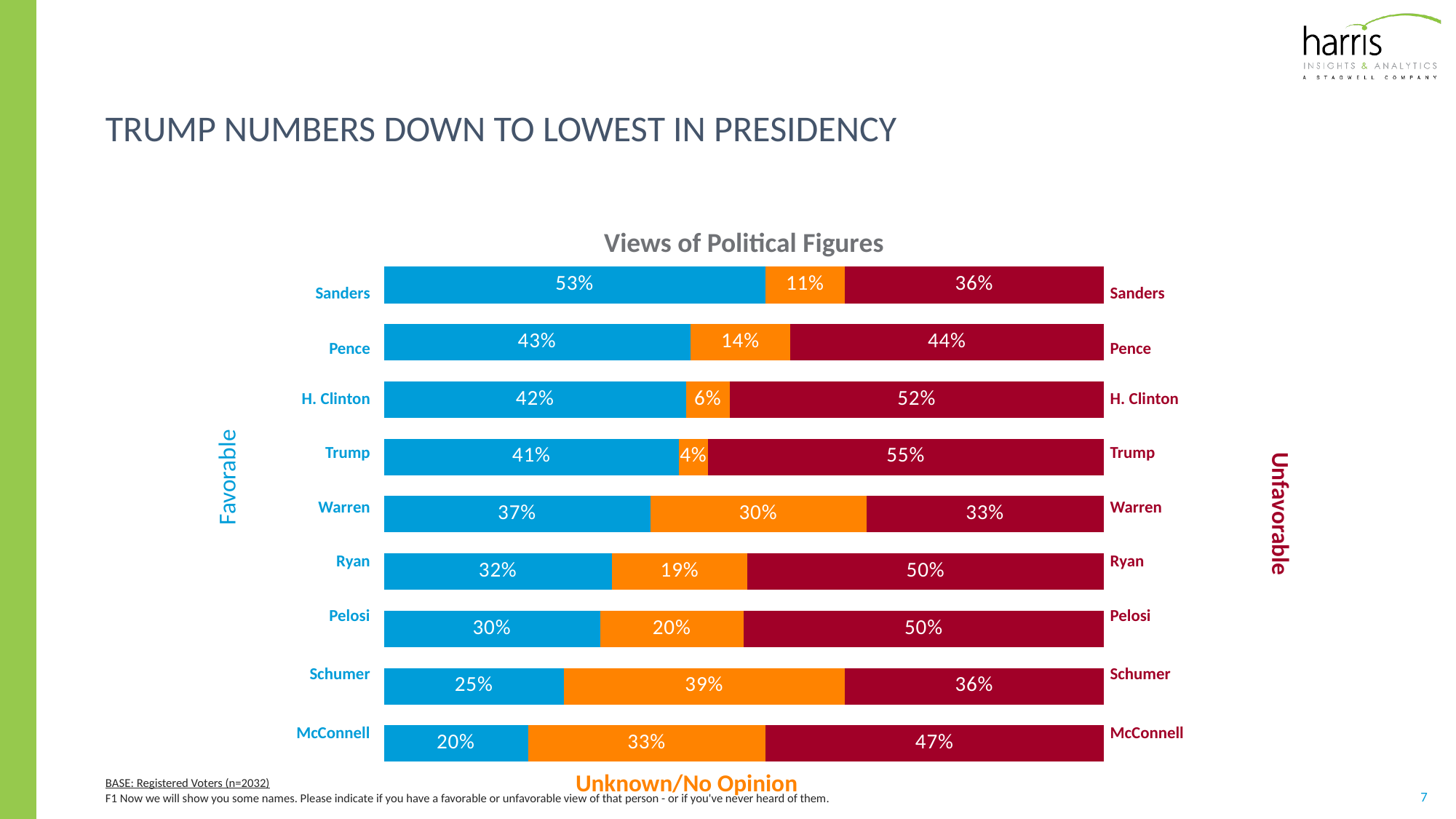
What is the Unknown/No Opinion value for Schumer? 39% How many political figures are shown in the chart? 9 Which political figure has the highest Unfavorable value? Trump What is the Favorable value for Sanders? 53% Which political figure has the highest Favorable value? Sanders What is the Unfavorable value for Trump? 55% Which is larger for Pence: the Favorable value or the Unfavorable value? Unfavorable What kind of chart is shown on the slide? Stacked bar chart How many series does the chart show? 3 What is the title of the chart? Views of Political Figures What is the difference between the Unfavorable and Favorable values for H. Clinton? 10% Which political figure has the lowest Favorable value? McConnell